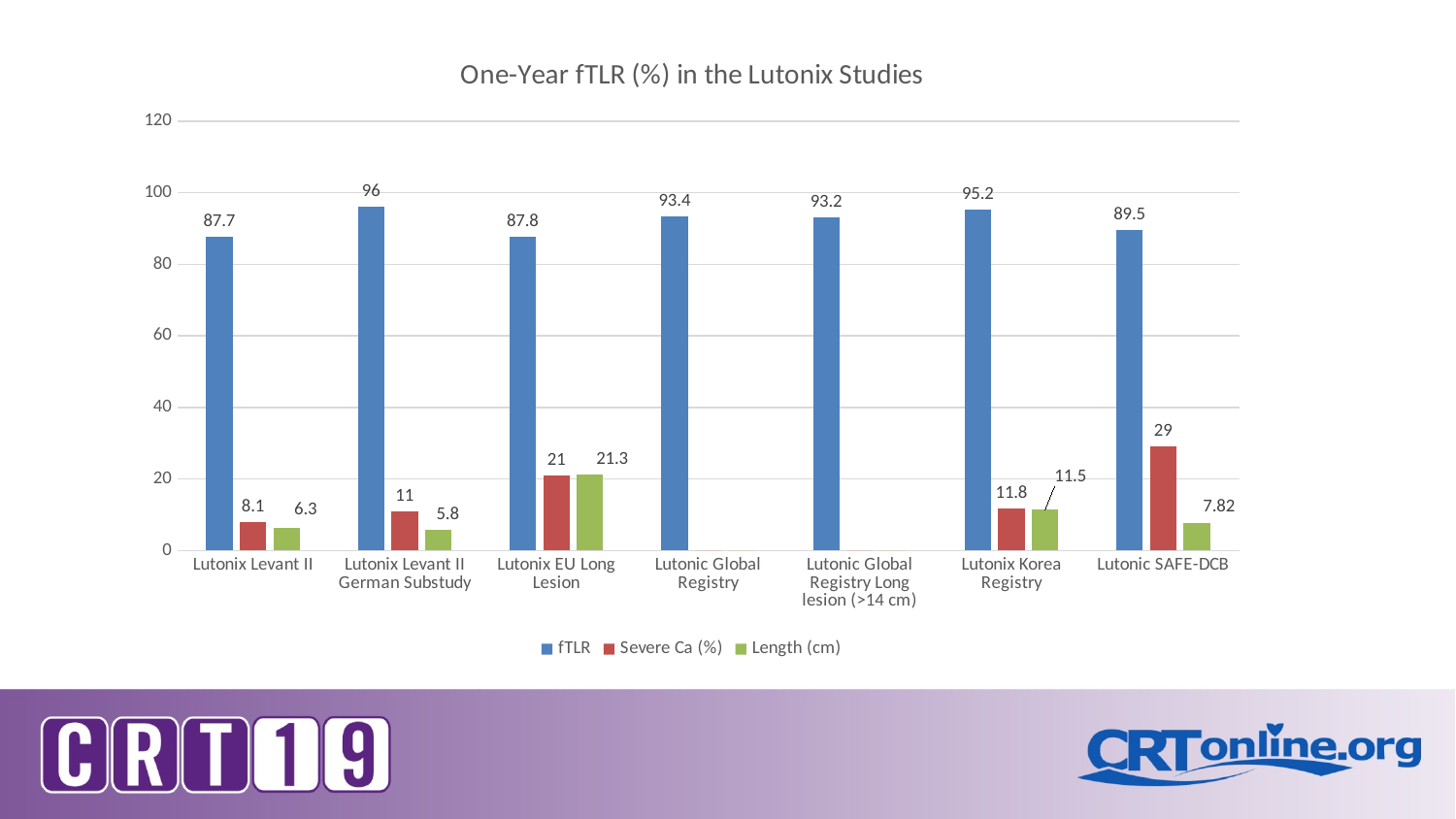
What is the Severe Ca (%) value for Lutonic SAFE-DCB? 29 Which study has the lowest fTLR value? Lutonix Levant II What is the difference between the fTLR values for Lutonix Korea Registry and Lutonic SAFE-DCB? 5.7 Which study has the highest fTLR value? Lutonix Levant II German Substudy Which is larger, the Severe Ca (%) value for Lutonix Levant II German Substudy or for Lutonix Korea Registry? Lutonix Korea Registry What is the fTLR value for Lutonix Levant II? 87.7 What is the Length (cm) value for Lutonix Levant II German Substudy? 5.8 What is the Length (cm) value for Lutonix EU Long Lesion? 21.3 What is the title of the chart? One-Year fTLR (%) in the Lutonix Studies What kind of chart is shown on the slide? Bar chart How many series does the legend list? 3 How many studies are shown on the x axis? 7